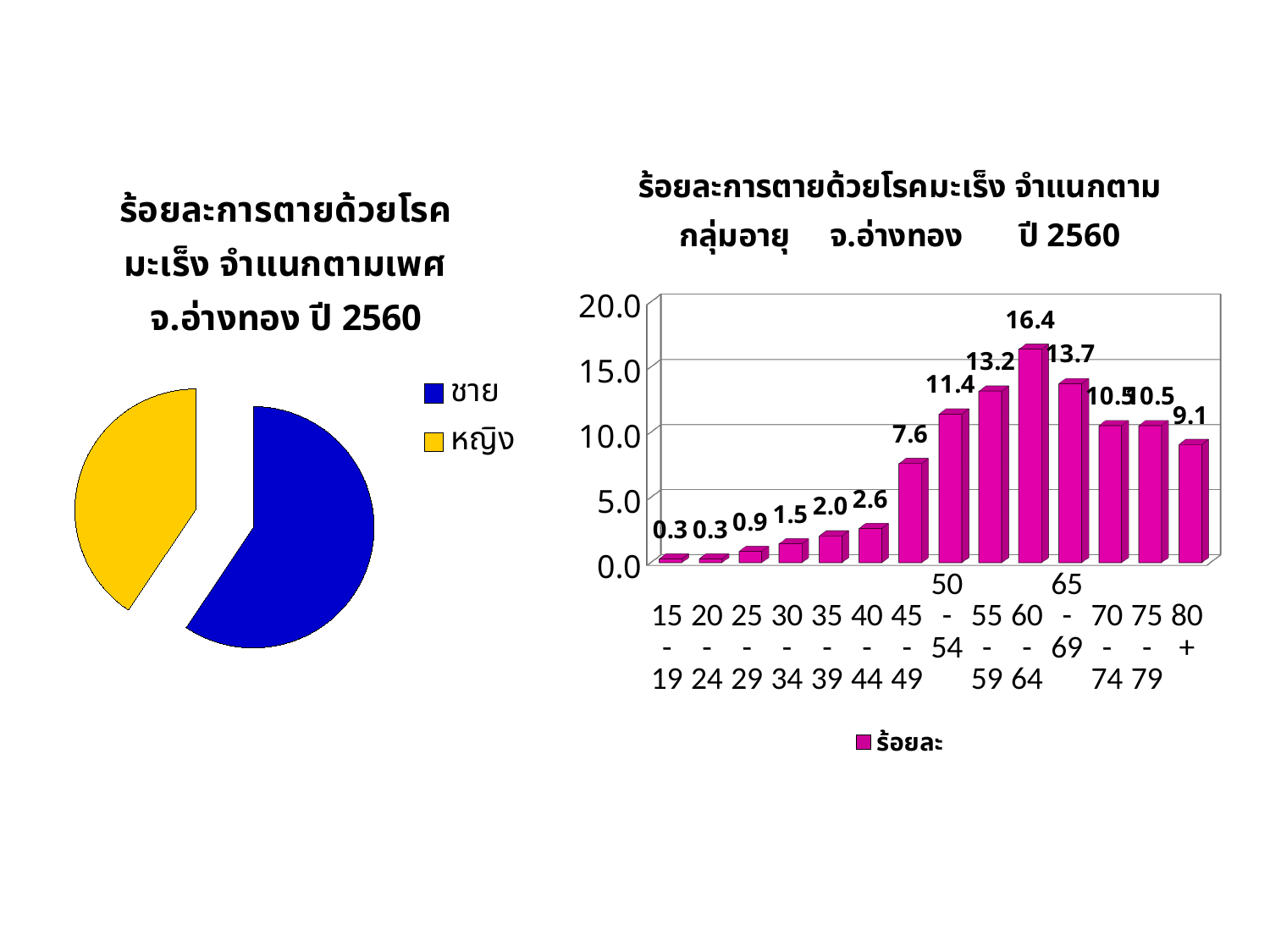
In the bar chart on the right, which age group has the highest value? 60-64 In the bar chart on the right, do the values rise or fall from the 15-19 group to the 60-64 group? rise How many series does the legend of the pie chart on the left list? 2 In the bar chart on the right, what is the value for the 60-64 age group? 16.4 What kind of chart is the chart on the left? pie chart In the bar chart on the right, how many age groups are shown? 14 In the bar chart on the right, which is larger, the value for 55-59 or the value for 50-54? 55-59 In the bar chart on the right, what is the value for the 80+ age group? 9.1 In the pie chart on the left, what colour is the ชาย slice? blue In the bar chart on the right, what is the difference between the values for the 60-64 and 65-69 age groups? 2.7 In the pie chart on the left, which slice is larger, ชาย or หญิง? ชาย In the bar chart on the right, what is the value for the 45-49 age group? 7.6